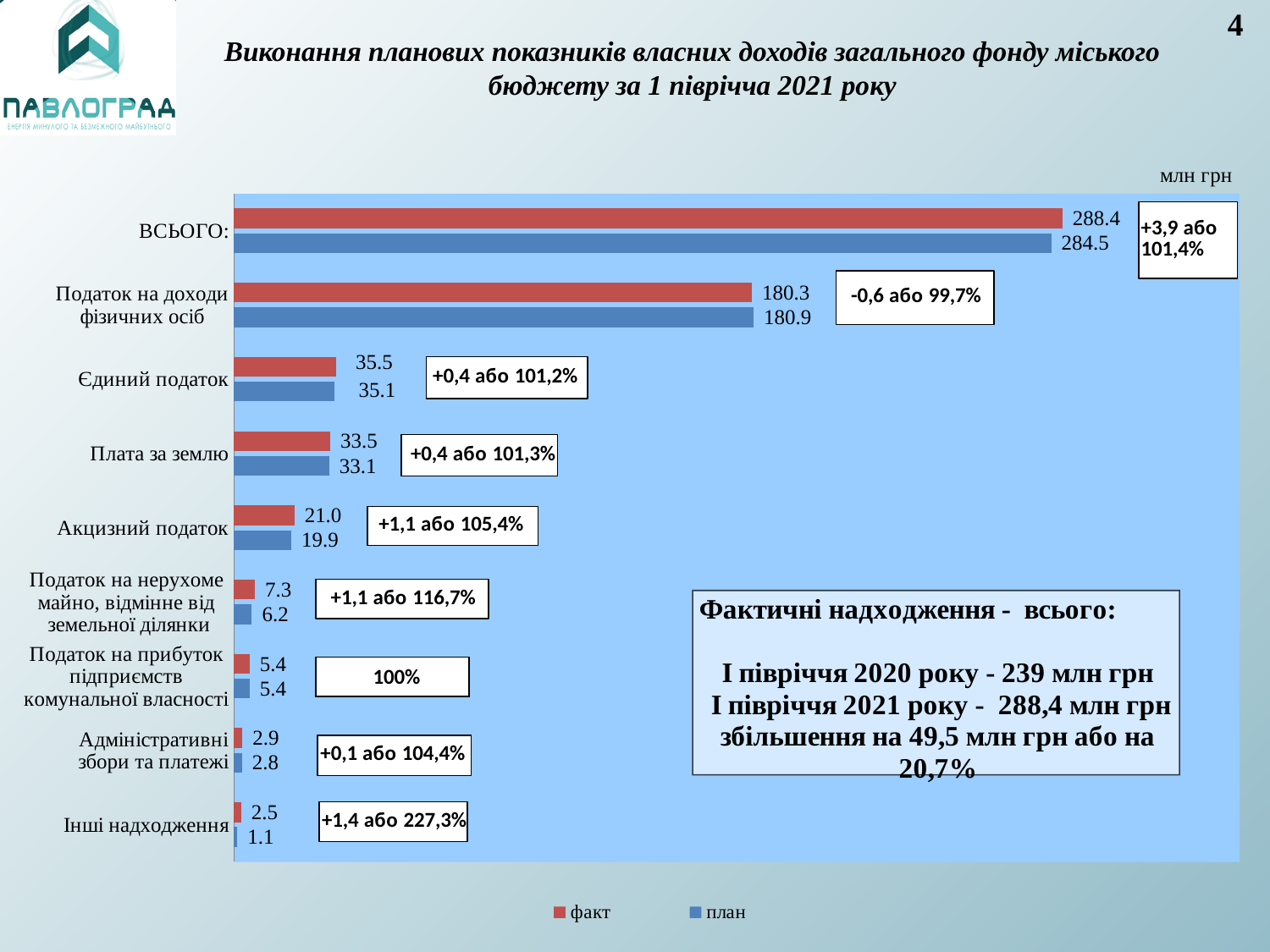
What is the difference between the факт and план values for ВСЬОГО? 3.9 Which category has the lowest план value? Інші надходження What is the план value for Єдиний податок? 35.1 What kind of chart is shown on the slide? bar chart What is the факт value for Акцизний податок? 21.0 What is the план value for Інші надходження? 1.1 How many categories are shown on the chart, including ВСЬОГО? 9 Which colour represents the факт series in the chart? red How many series does the legend list? 2 Excluding the ВСЬОГО total row, which category has the highest факт value? Податок на доходи фізичних осіб Which is larger for Податок на доходи фізичних осіб, the факт value or the план value? план What is the факт value for Податок на доходи фізичних осіб? 180.3